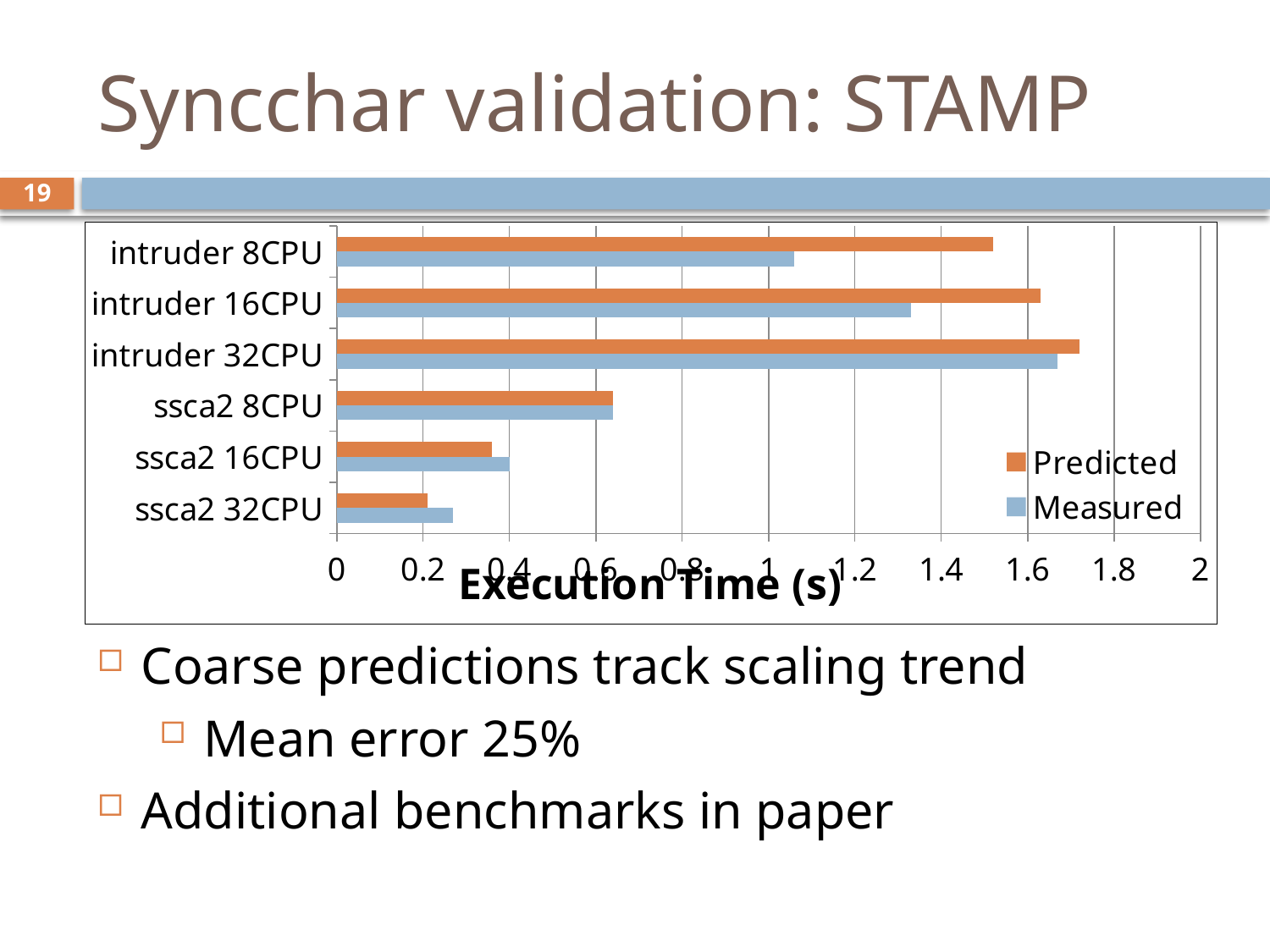
How many categories are plotted on the chart? 6 Which category has the highest Predicted execution time? intruder 32CPU What kind of chart is shown on the slide? bar chart Is the Measured value for ssca2 32CPU greater or less than 0.4? less Is the Predicted value for intruder 8CPU greater or less than 1.4? greater Which category has the lowest Measured execution time? ssca2 32CPU Which category has the lowest Predicted execution time? ssca2 32CPU How many series does the legend list? 2 For ssca2 32CPU, which is larger: the Predicted or the Measured execution time? Measured For intruder 8CPU, which is larger: the Predicted or the Measured execution time? Predicted Is the Measured value for intruder 8CPU greater or less than 1.2? less What is the title of the x axis? Execution Time (s)